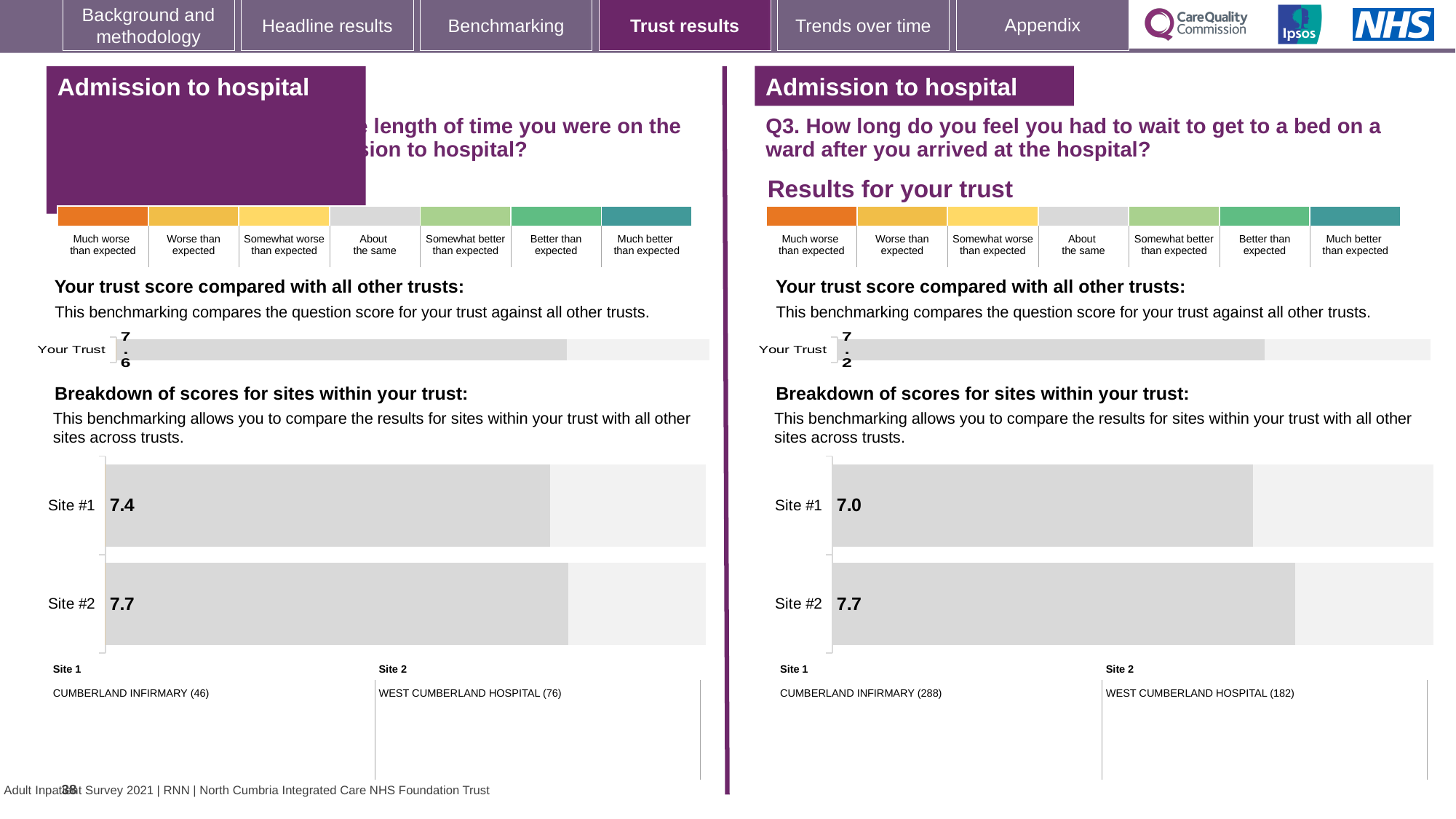
For Q3 (wait to get to a bed on a ward), what is the score shown for Site #1? 7.0 On the left-hand side of the slide, what is the 'Your Trust' score in the trust score comparison chart? 7.6 What type of chart is used to show the breakdown of scores for sites within your trust on the right-hand side of the slide? Bar chart On the left-hand side of the slide, what is the difference between the Site #2 and Site #1 scores? 0.3 For Q3 (wait to get to a bed on a ward), what is the score shown for Site #2? 7.7 For Q3 (wait to get to a bed on a ward), what is the difference between the Site #2 and Site #1 scores? 0.7 For Q3 (wait to get to a bed on a ward), what is the 'Your Trust' score in the trust score comparison chart? 7.2 How many sites are shown in the breakdown of scores chart for Q3 (wait to get to a bed on a ward)? 2 On the left-hand side of the slide, which site has the higher score in the breakdown of scores for sites within your trust? Site #2 On the left-hand side of the slide, what is the score shown for Site #1 in the breakdown of scores for sites within your trust? 7.4 On the left-hand side of the slide, what is the score shown for Site #2 in the breakdown of scores for sites within your trust? 7.7 For Q3 (wait to get to a bed on a ward), which site has the lower score in the breakdown of scores for sites within your trust? Site #1